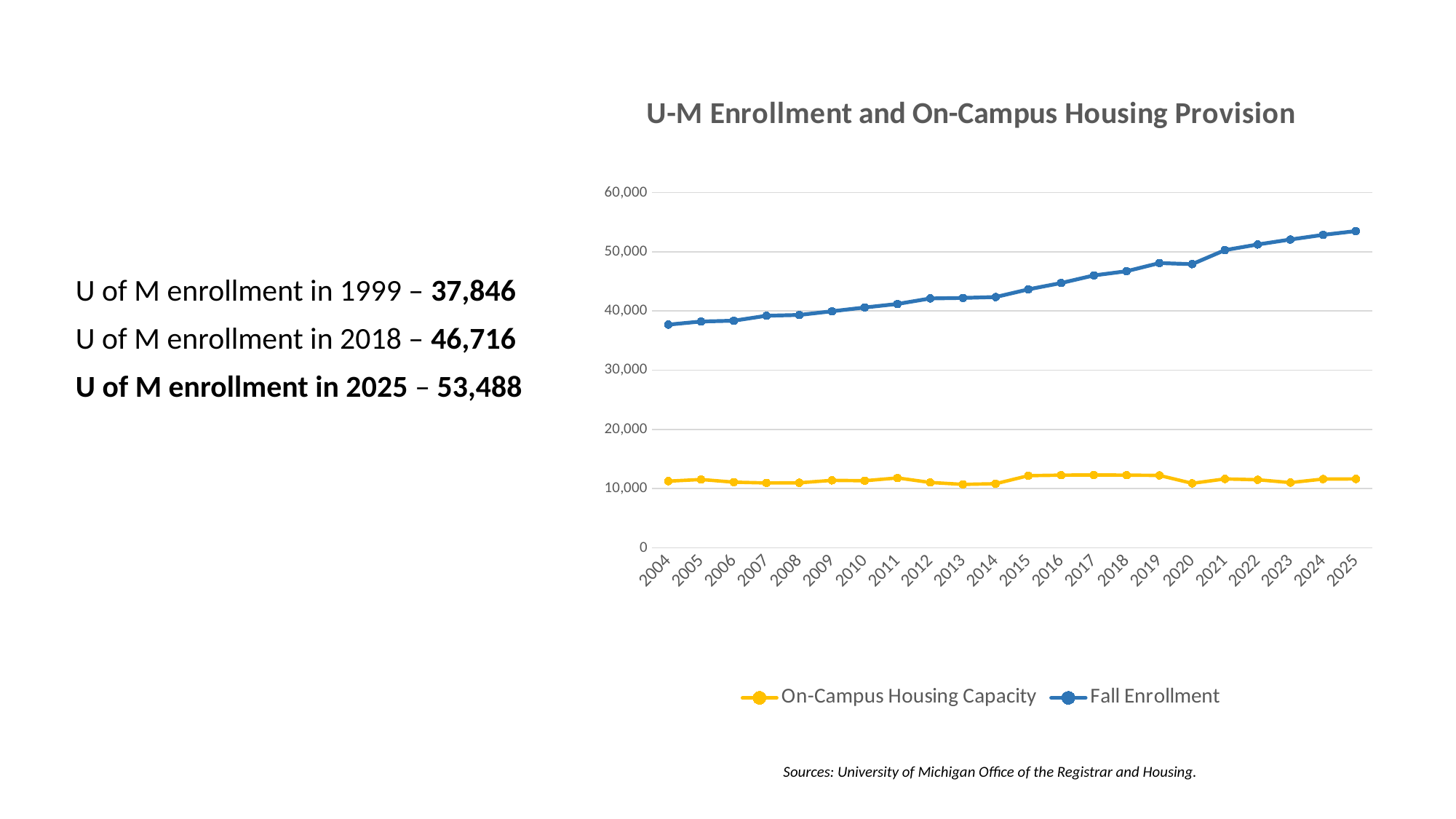
How many series does the chart's legend list? 2 In which year is Fall Enrollment highest? 2025 Which series is drawn in yellow in the chart? On-Campus Housing Capacity How many years are shown on the x axis of the chart? 22 In which year is Fall Enrollment lowest? 2004 Is the Fall Enrollment value for 2025 greater or less than 50,000? greater Is the On-Campus Housing Capacity value for 2015 greater or less than 20,000? less In 2025, which is larger: Fall Enrollment or On-Campus Housing Capacity? Fall Enrollment What kind of chart is shown on the slide? line chart What is the title of the chart? U-M Enrollment and On-Campus Housing Provision Is the Fall Enrollment value for 2004 greater or less than 40,000? less Does Fall Enrollment generally rise or fall from 2004 to 2025? rise